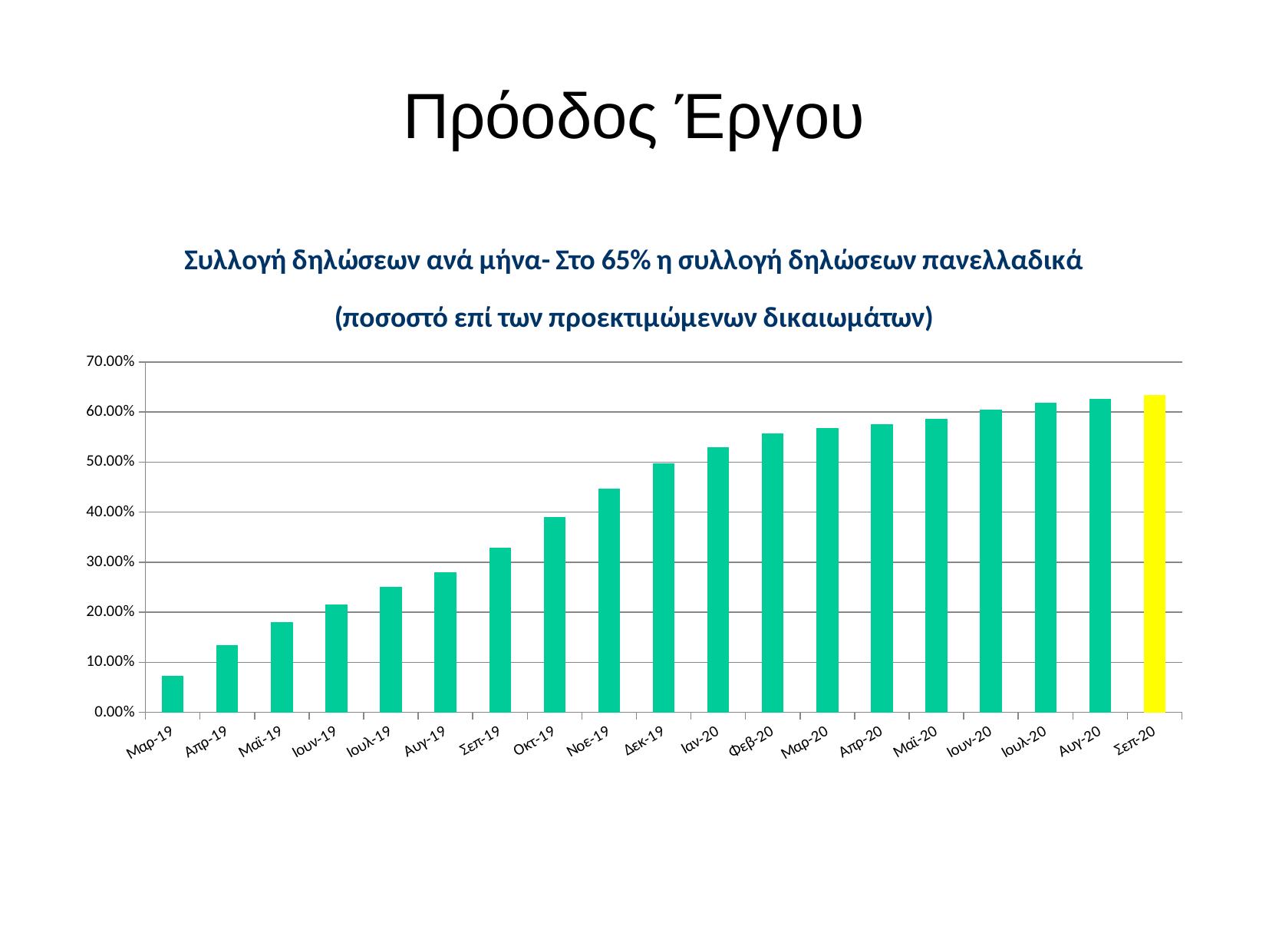
Is the value for Σεπ-20 greater or less than 60.00%? greater What kind of chart is shown on the slide? Bar chart Which bar is coloured yellow instead of green? Σεπ-20 Is the value for Αυγ-19 greater or less than 30.00%? less Which month has the highest value on the chart? Σεπ-20 Which month has the lowest value on the chart? Μαρ-19 What is the highest tick value shown on the vertical axis? 70.00% Which is larger, the value for Οκτ-19 or the value for Μαϊ-19? Οκτ-19 Is the value for Νοε-19 greater or less than 40.00%? greater Do the values rise or fall from Μαρ-19 to Σεπ-20? Rise How many months (bars) are plotted on the chart? 19